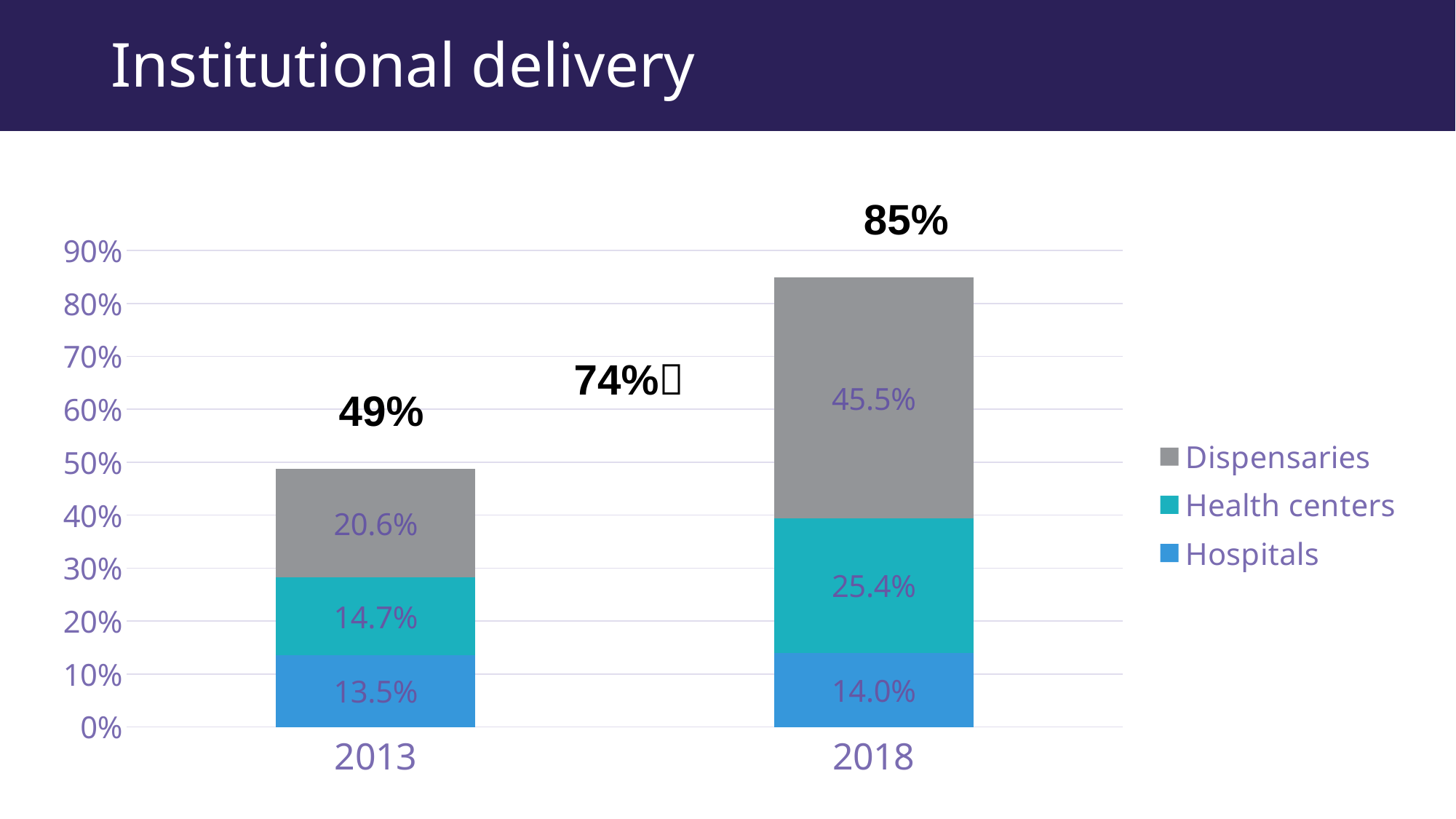
What is the value for Dispensaries in 2018? 45.5% How many series does the legend list? 3 Which is larger, Health centers in 2013 or Health centers in 2018? Health centers in 2018 What is the value for Health centers in 2018? 25.4% What is the total labelled above the 2018 bar? 85% What is the total labelled above the 2013 bar? 49% What is the value for Dispensaries in 2013? 20.6% Which series has the highest value in 2018? Dispensaries What kind of chart is shown? Stacked bar chart What is the title of the slide? Institutional delivery What is the difference between the Dispensaries values for 2018 and 2013? 24.9% What is the value for Hospitals in 2013? 13.5%